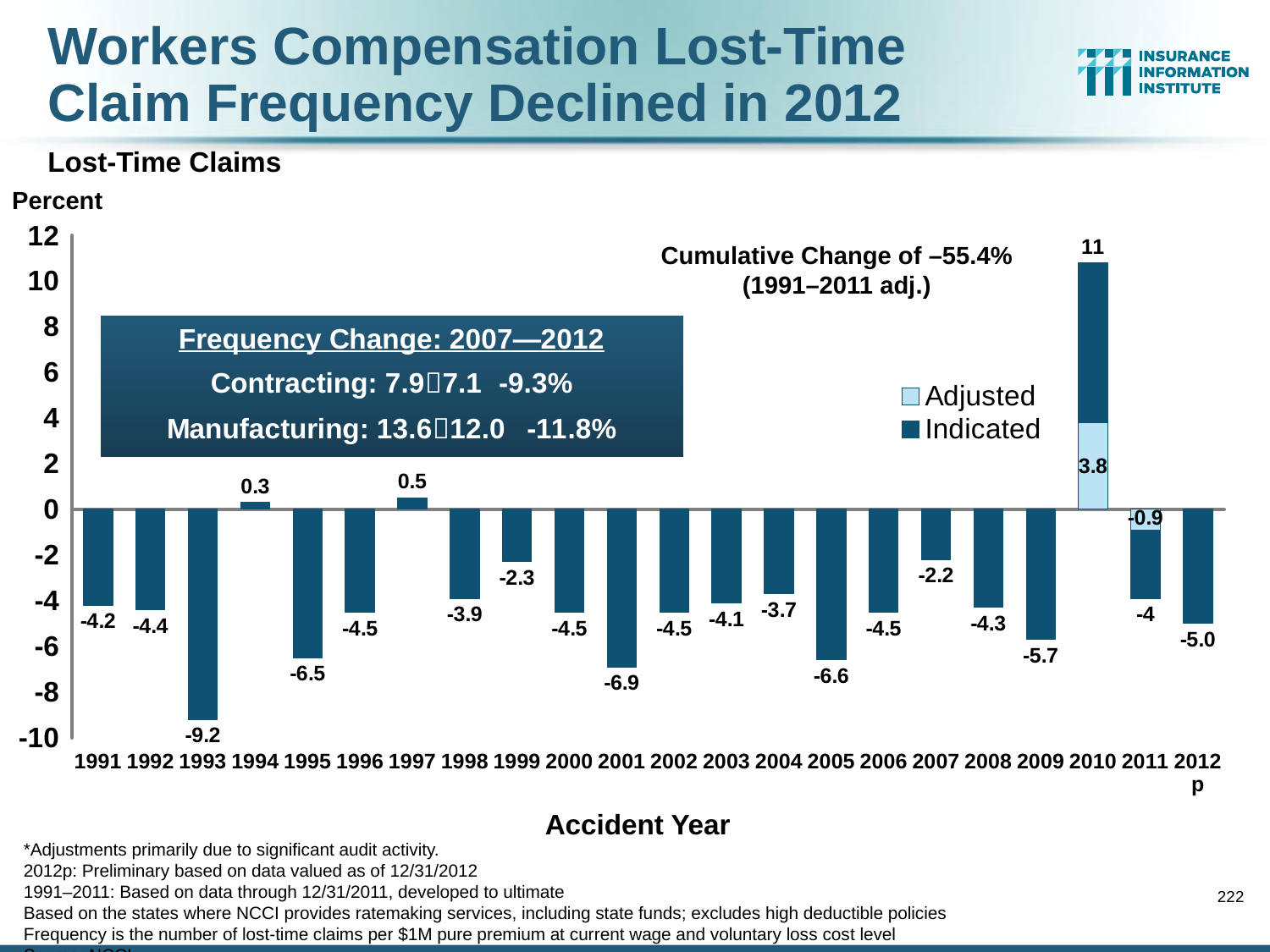
How many series does the legend list? 2 What is the Indicated value for 2010? 11 What is the Adjusted value for 2010? 3.8 What kind of chart is shown? Bar chart What is the difference between the values for 2005 and 2007? 4.4 Which accident year has the lowest value? 1993 What is the value for 2001? -6.9 Which accident year has the highest value? 2010 What is the value for 2012p? -5.0 How many accident years are shown on the x axis? 22 Which is larger, the value for 1994 or the value for 1997? 1997 What is the value for 1993? -9.2